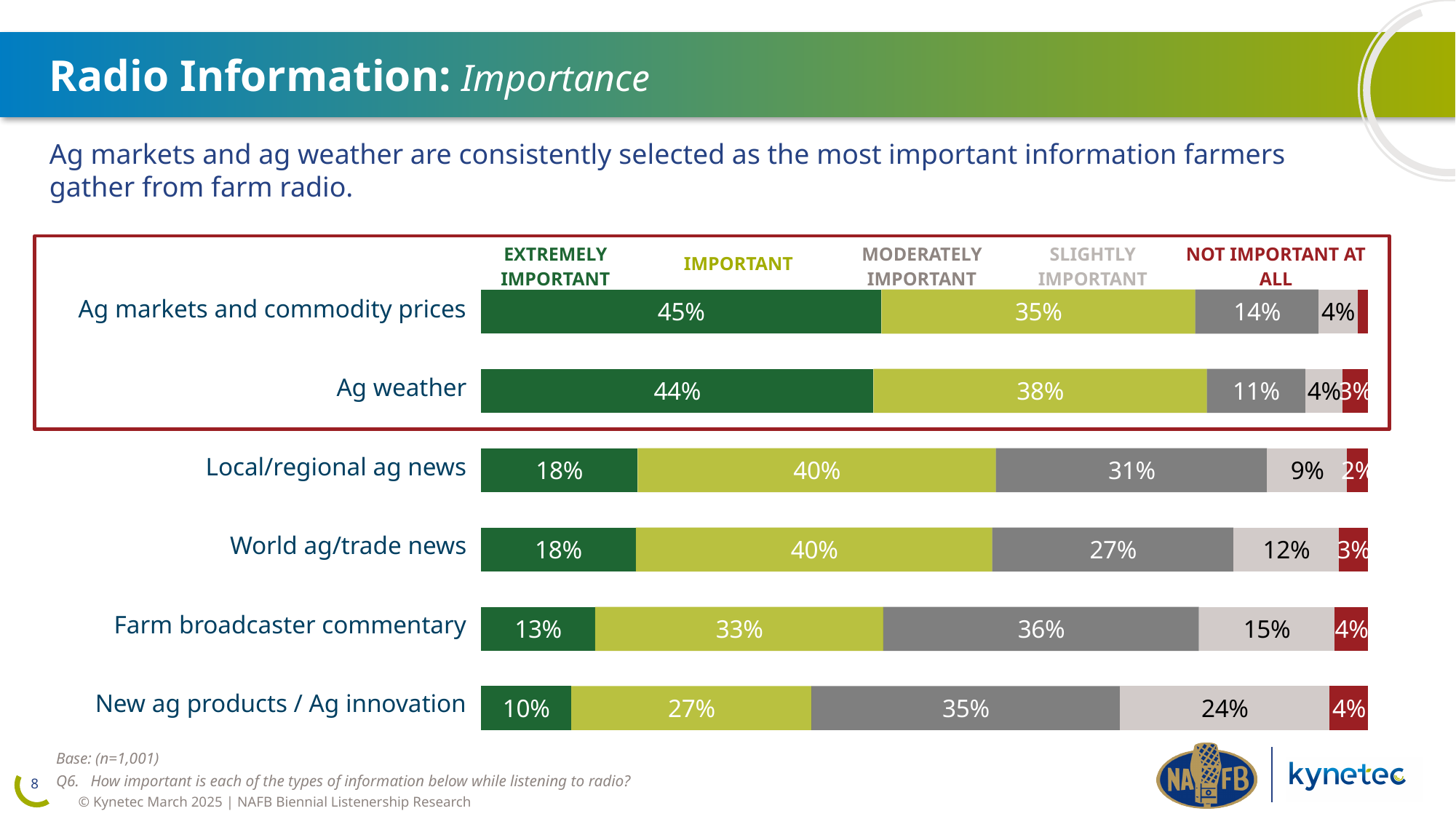
What type of chart is shown on the slide? Stacked bar chart How many importance levels (series) does the chart show? 5 What is the Important value for Ag weather? 38% What percentage of respondents rated Ag markets and commodity prices as Extremely Important? 45% What percentage rated New ag products / Ag innovation as Slightly Important? 24% Which two categories are highlighted with a red outline box? Ag markets and commodity prices and Ag weather What is the difference between the Extremely Important values for Ag weather and Local/regional ag news? 26 percentage points What is the Moderately Important value for Farm broadcaster commentary? 36% Which category has the lowest Extremely Important percentage? New ag products / Ag innovation How many information types are shown in the chart? 6 Which is larger: the Moderately Important value for Local/regional ag news or for World ag/trade news? Local/regional ag news Which category has the highest Extremely Important percentage? Ag markets and commodity prices